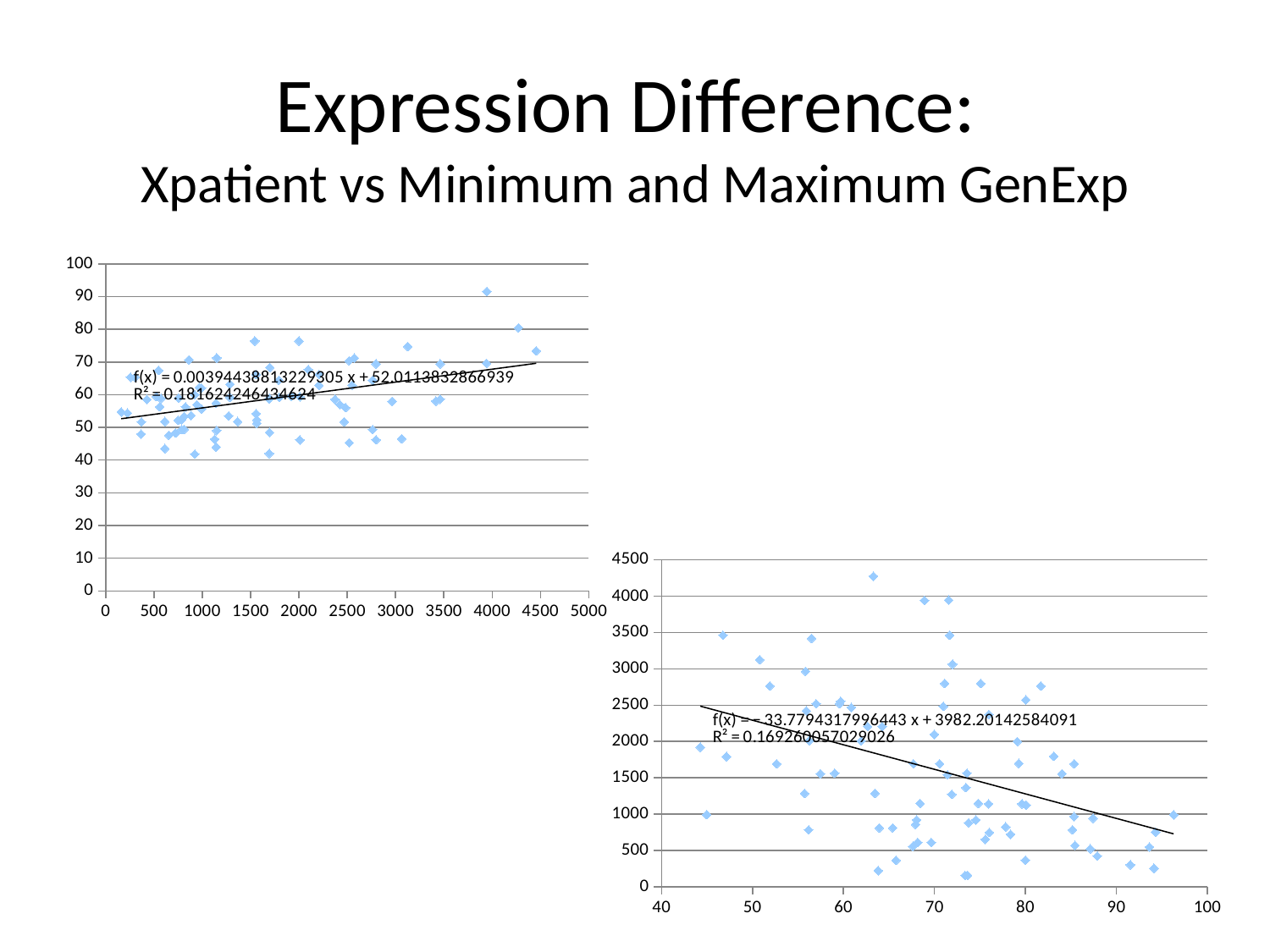
In the top-left chart, does the fitted trendline rise or fall as x increases? rise In the bottom-right chart, does the fitted trendline rise or fall as x increases? fall What kind of chart is the bottom-right chart on the slide? scatter chart What R² value is printed on the top-left chart? 0.181624246434624 In the bottom-right chart, is the highest plotted point greater or less than 4000? greater In the top-left chart, is the highest plotted point greater or less than 80? greater What R² value is printed on the bottom-right chart? 0.169260057029026 What kind of chart is the top-left chart on the slide? scatter chart In the bottom-right chart, is the lowest plotted point greater or less than 500? less